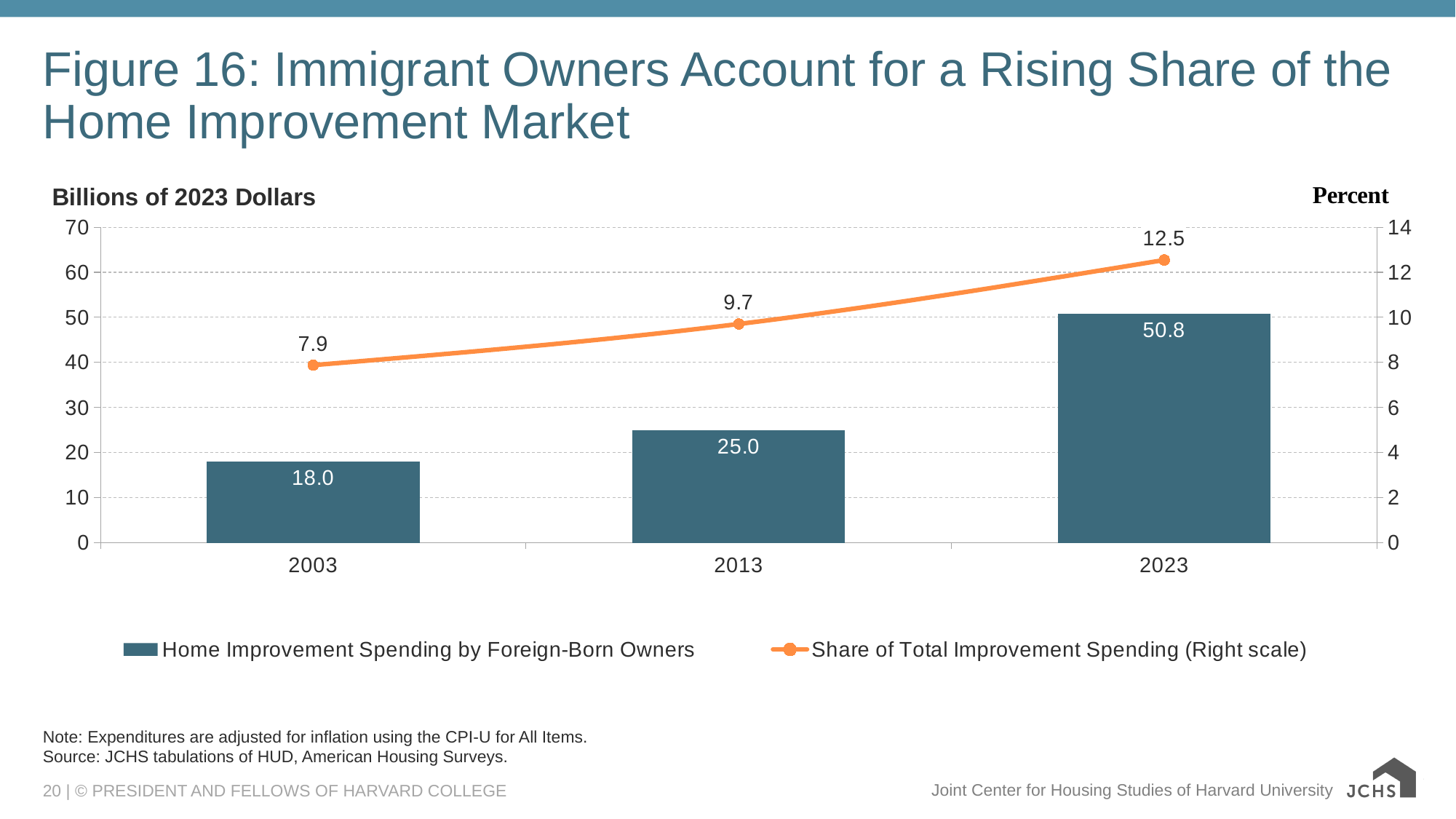
What was home improvement spending by foreign-born owners in 2023? 50.8 By how many percentage points did the share of total improvement spending rise from 2013 to 2023? 2.8 Which year had the lowest share of total improvement spending? 2003 What was home improvement spending by foreign-born owners in 2013? 25.0 How many years are shown on the x axis? 3 Does the share of total improvement spending rise or fall from 2003 to 2023? rise Was home improvement spending by foreign-born owners larger in 2013 or in 2003? 2013 Which year had the highest home improvement spending by foreign-born owners? 2023 How many series does the legend list? 2 What was the share of total improvement spending in 2003? 7.9 What unit is shown on the left axis label? Billions of 2023 Dollars How much higher was home improvement spending by foreign-born owners in 2023 than in 2003? 32.8